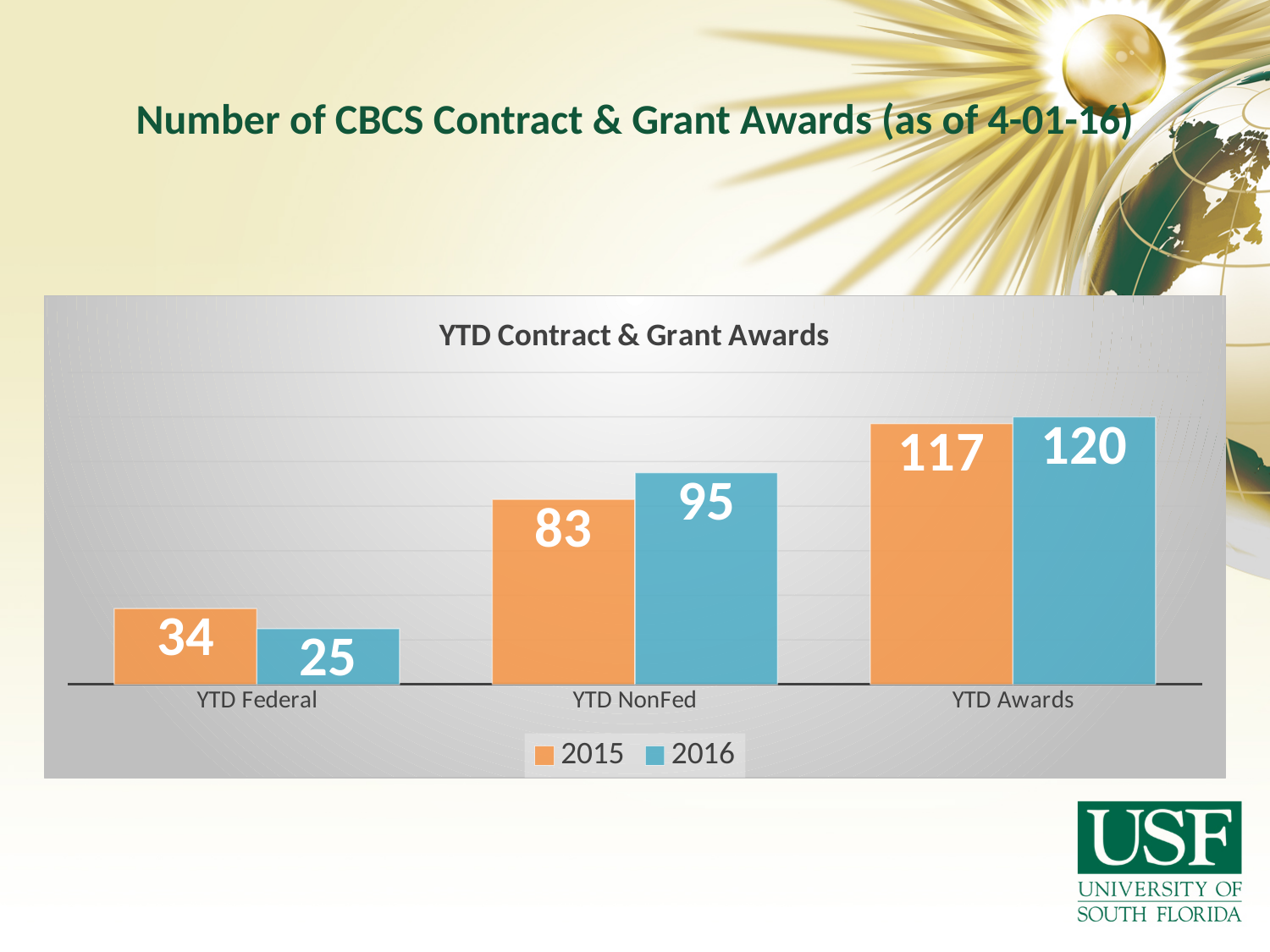
What is the 2015 value for YTD Federal? 34 Which is larger for YTD Awards, the 2015 value or the 2016 value? 2016 What is the 2016 value for YTD Awards? 120 What is the 2016 value for YTD NonFed? 95 What kind of chart is shown on the slide? Bar chart How many series does the legend list? 2 How many categories are shown on the x axis? 3 What is the difference between the 2016 and 2015 values for YTD NonFed? 12 What is the difference between the 2015 and 2016 values for YTD Federal? 9 Which category has the lowest 2015 value? YTD Federal Which category has the highest 2016 value? YTD Awards What is the 2015 value for YTD NonFed? 83